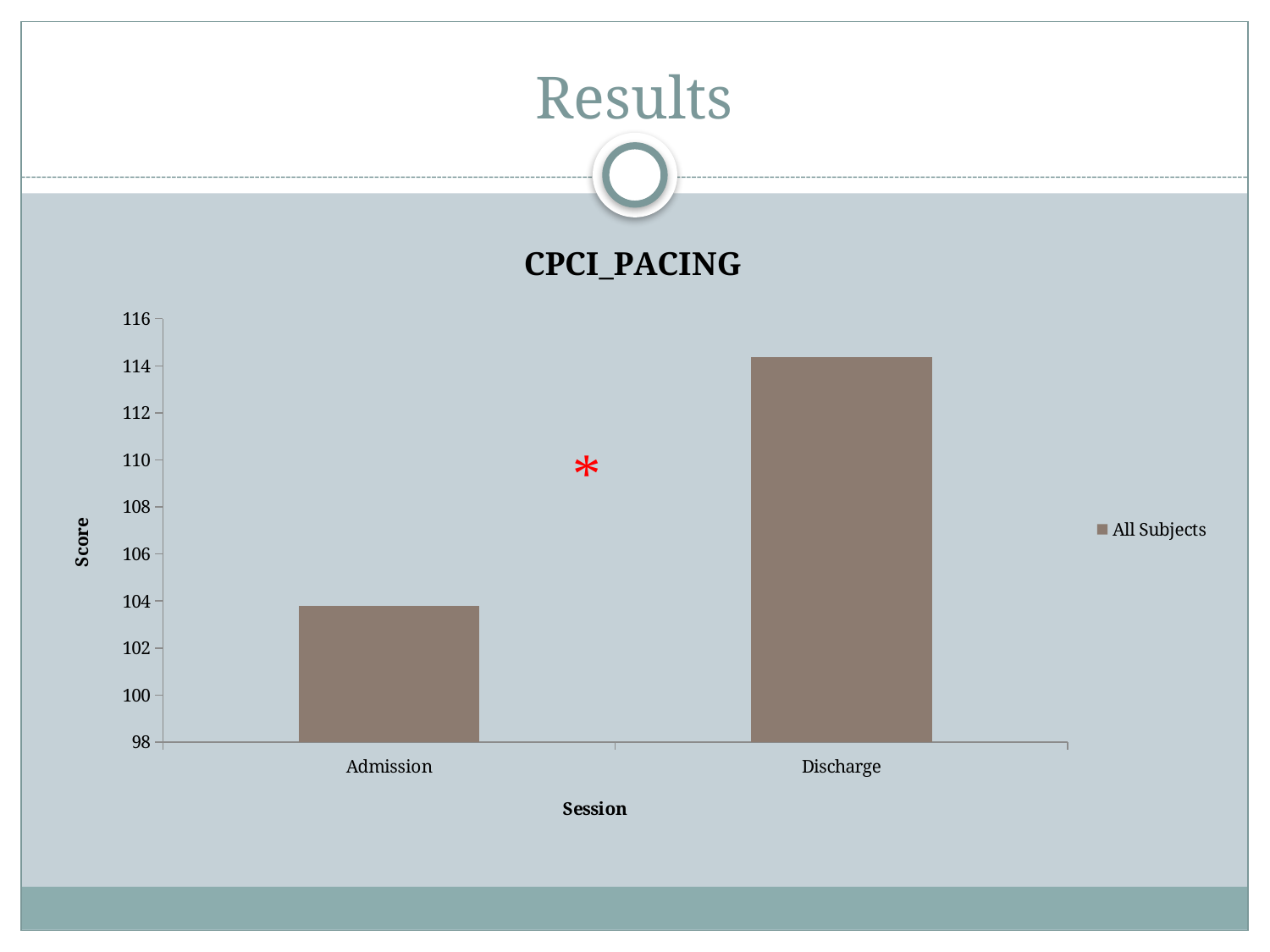
Do the scores rise or fall from Admission to Discharge? rise What is the title of the chart? CPCI_PACING How many categories are shown on the x axis? 2 What kind of chart is shown on the slide? bar chart Is the score for Admission greater or less than 102? greater What is the label of the series in the legend? All Subjects How many series does the legend list? 1 Is the score for Discharge greater or less than 114? greater Is the score for Discharge greater or less than 116? less Which session has the lower score? Admission Which session has the higher score? Discharge